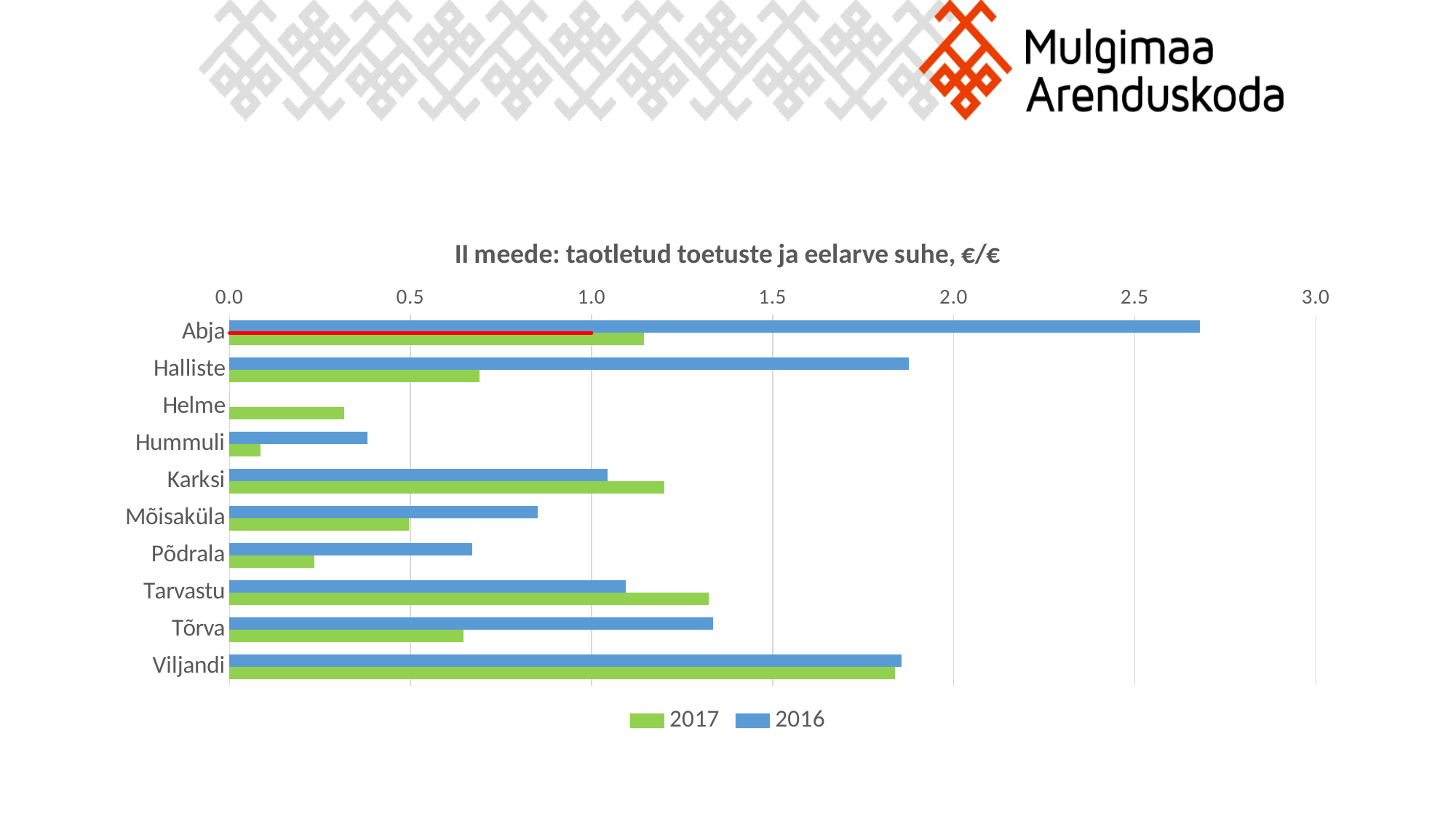
How many categories are shown on the vertical axis of the chart? 10 What is the title of the chart? II meede: taotletud toetuste ja eelarve suhe, €/€ How many series does the legend list? 2 Which category has the highest 2016 value? Abja For Halliste, which series has the larger value, 2016 or 2017? 2016 Is the 2016 value for Halliste greater or less than 1.5? greater Which category has the lowest 2017 value? Hummuli Is the 2017 value for Helme greater or less than 0.5? less Which category has the highest 2017 value? Viljandi Is the 2016 value for Abja greater or less than 2.5? greater For Karksi, which series has the larger value, 2016 or 2017? 2017 What kind of chart is shown on the slide? bar chart